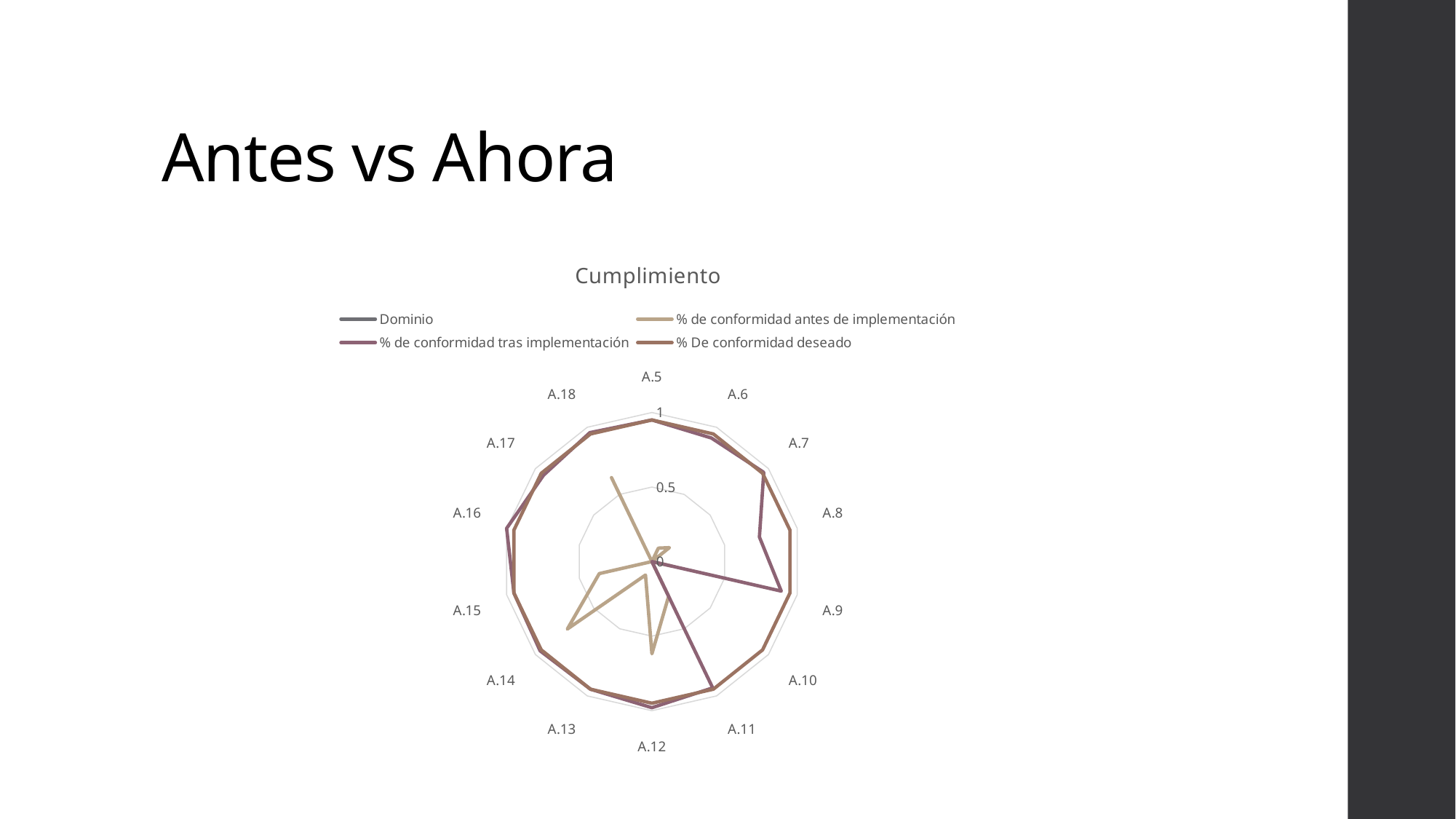
For A.12, which is larger: % de conformidad antes de implementación or % De conformidad deseado? % De conformidad deseado Is the value of % de conformidad tras implementación for A.5 greater or less than 0.5? greater How many series does the legend list? 4 Is the value of % de conformidad antes de implementación for A.9 greater or less than 0.5? less What is the title of the chart? Cumplimiento What is the highest tick value shown on the chart's radial axis? 1 Is the value of % de conformidad tras implementación for A.9 greater or less than 0.5? greater How many categories are plotted around the chart? 14 For A.5, which is larger: % de conformidad antes de implementación or % de conformidad tras implementación? % de conformidad tras implementación What kind of chart is shown on the slide? radar chart Which series is drawn in the tan colour according to the legend? % de conformidad antes de implementación